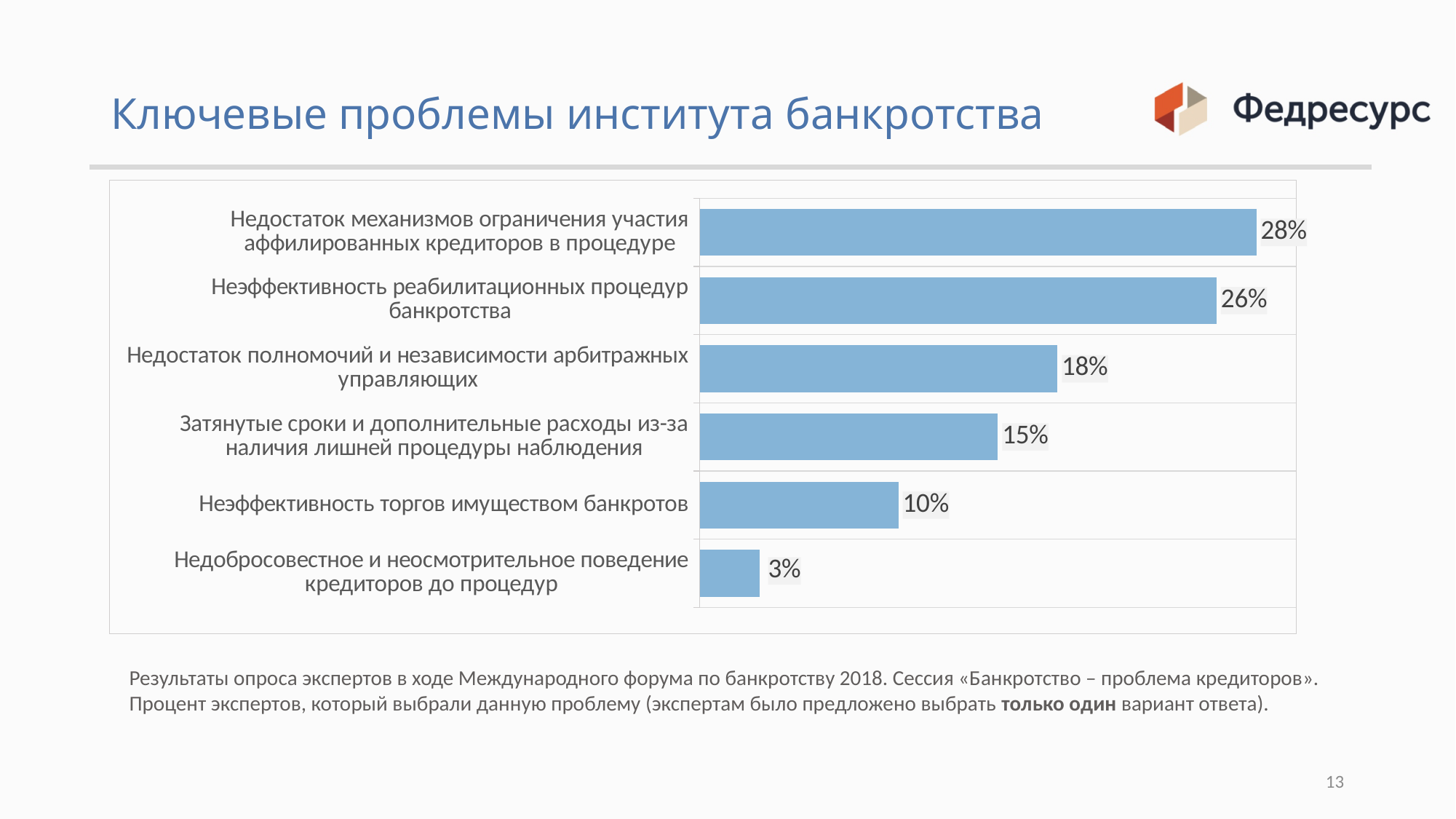
What is the difference between the values for «Неэффективность реабилитационных процедур банкротства» and «Недостаток полномочий и независимости арбитражных управляющих»? 8% What value is shown for «Затянутые сроки и дополнительные расходы из-за наличия лишней процедуры наблюдения»? 15% Which is larger: the value for «Недостаток полномочий и независимости арбитражных управляющих» or for «Неэффективность торгов имуществом банкротов»? Недостаток полномочий и независимости арбитражных управляющих What value is shown for «Неэффективность торгов имуществом банкротов»? 10% What percentage of experts chose «Недостаток механизмов ограничения участия аффилированных кредиторов в процедуре»? 28% What is the title of the slide containing the chart? Ключевые проблемы института банкротства What kind of chart is shown on the slide? Bar chart Which problem has the lowest percentage in the chart? Недобросовестное и неосмотрительное поведение кредиторов до процедур What is the difference between the highest and lowest values in the chart? 25% What colour are the bars in the chart? Blue Which problem has the highest percentage in the chart? Недостаток механизмов ограничения участия аффилированных кредиторов в процедуре How many problems (categories) are shown in the chart? 6